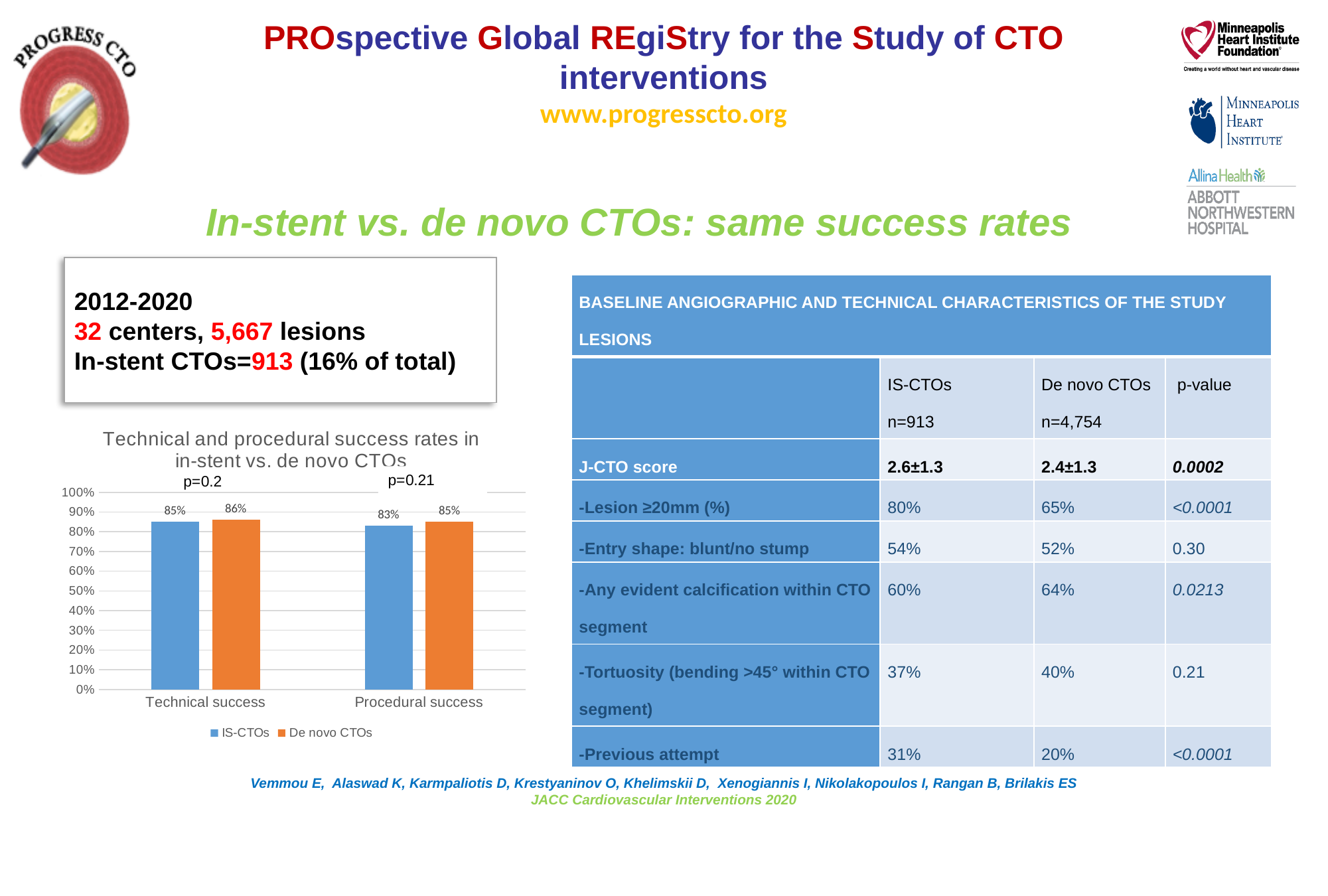
What is the technical success rate for IS-CTOs? 85% How many categories are shown on the x axis of the chart? 2 How many series does the chart legend list? 2 What is the technical success rate for De novo CTOs? 86% What is the title of the chart? Technical and procedural success rates in in-stent vs. de novo CTOs What p-value is shown above the Technical success bars? p=0.2 What is the procedural success rate for IS-CTOs? 83% What kind of chart is used to show the success rates? Bar chart What is the difference between the procedural success rates of De novo CTOs and IS-CTOs? 2% What is the difference between the technical success rates of De novo CTOs and IS-CTOs? 1% What is the procedural success rate for De novo CTOs? 85% Is the procedural success rate for IS-CTOs greater or less than 80%? greater